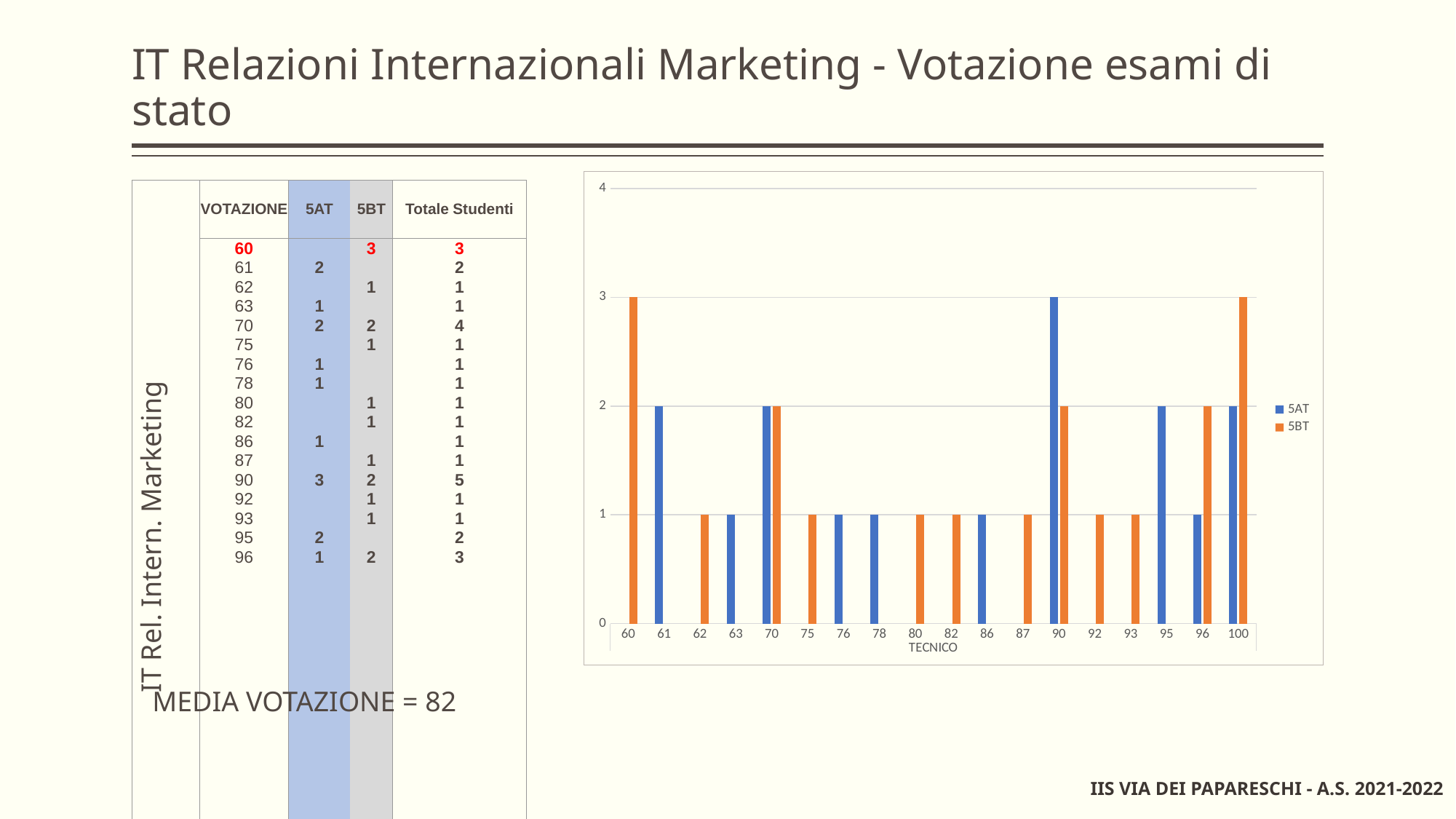
What is the difference between the 5AT and 5BT values for category 90? 1 What kind of chart is shown on the slide? bar chart What is the value of 5BT for category 100 in the chart? 3 For category 100, which series has the larger value, 5AT or 5BT? 5BT Which series is drawn in orange in the chart? 5BT What is the value of 5AT for category 95 in the chart? 2 What is the value of 5AT for category 90 in the chart? 3 How many categories are shown along the x axis of the chart? 18 How many series does the chart's legend list? 2 What is the title of the x axis of the chart? TECNICO Which category has the highest 5AT value in the chart? 90 What is the value of 5BT for category 60 in the chart? 3